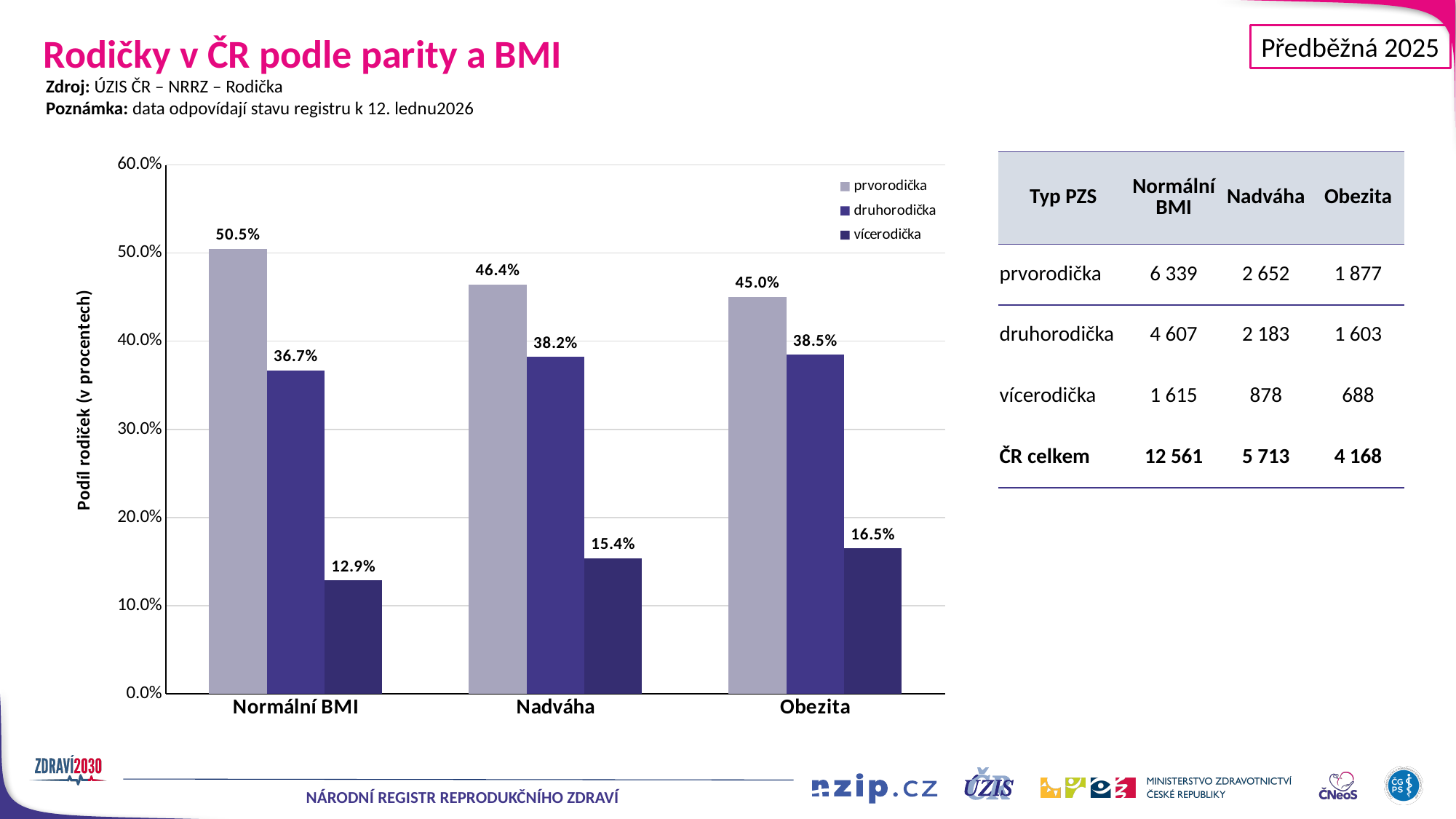
How many categories are shown on the x axis? 3 In which category is the prvorodička series highest? Normální BMI What is the value for vícerodička in the Obezita category? 16.5% What kind of chart is shown on the slide? bar chart Does the vícerodička series rise or fall from Normální BMI to Obezita? rise What is the value for druhorodička in the Nadváha category? 38.2% Which is larger: the druhorodička value for Nadváha or for Obezita? Obezita How many series does the legend list? 3 Is the value for prvorodička in the Obezita category greater or less than 40.0%? greater What is the difference between the prvorodička and druhorodička values in the Normální BMI category? 13.8% What is the value for prvorodička in the Normální BMI category? 50.5% In which category is the vícerodička series lowest? Normální BMI